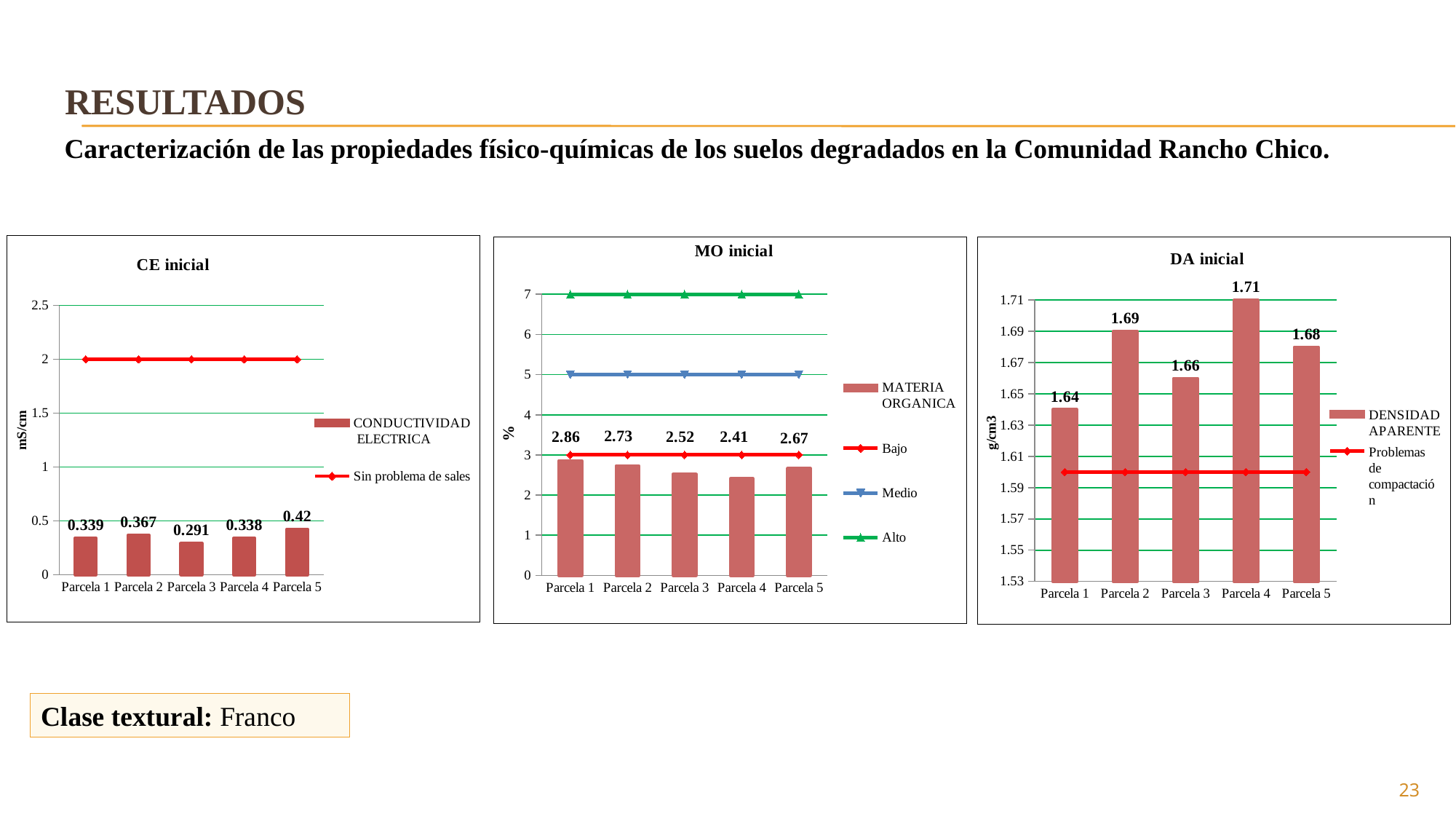
In the DA inicial chart, what is the value for Parcela 3? 1.66 In the MO inicial chart, what is the value for Parcela 4? 2.41 In the CE inicial chart, what is the difference between the values for Parcela 2 and Parcela 1? 0.028 In the MO inicial chart, which parcela has the highest materia orgánica? Parcela 1 In the MO inicial chart, is the value for Parcela 2 greater or less than 3? less In the DA inicial chart, which parcela has the highest densidad aparente? Parcela 4 How many parcelas are shown on the x axis of the DA inicial chart? 5 In the MO inicial chart, how many entries does the legend list? 4 In the CE inicial chart, what is the value for Parcela 5? 0.42 In the CE inicial chart, which parcela has the lowest conductividad eléctrica? Parcela 3 In the CE inicial chart, how many entries does the legend list? 2 In the DA inicial chart, what is the difference between the values for Parcela 4 and Parcela 1? 0.07